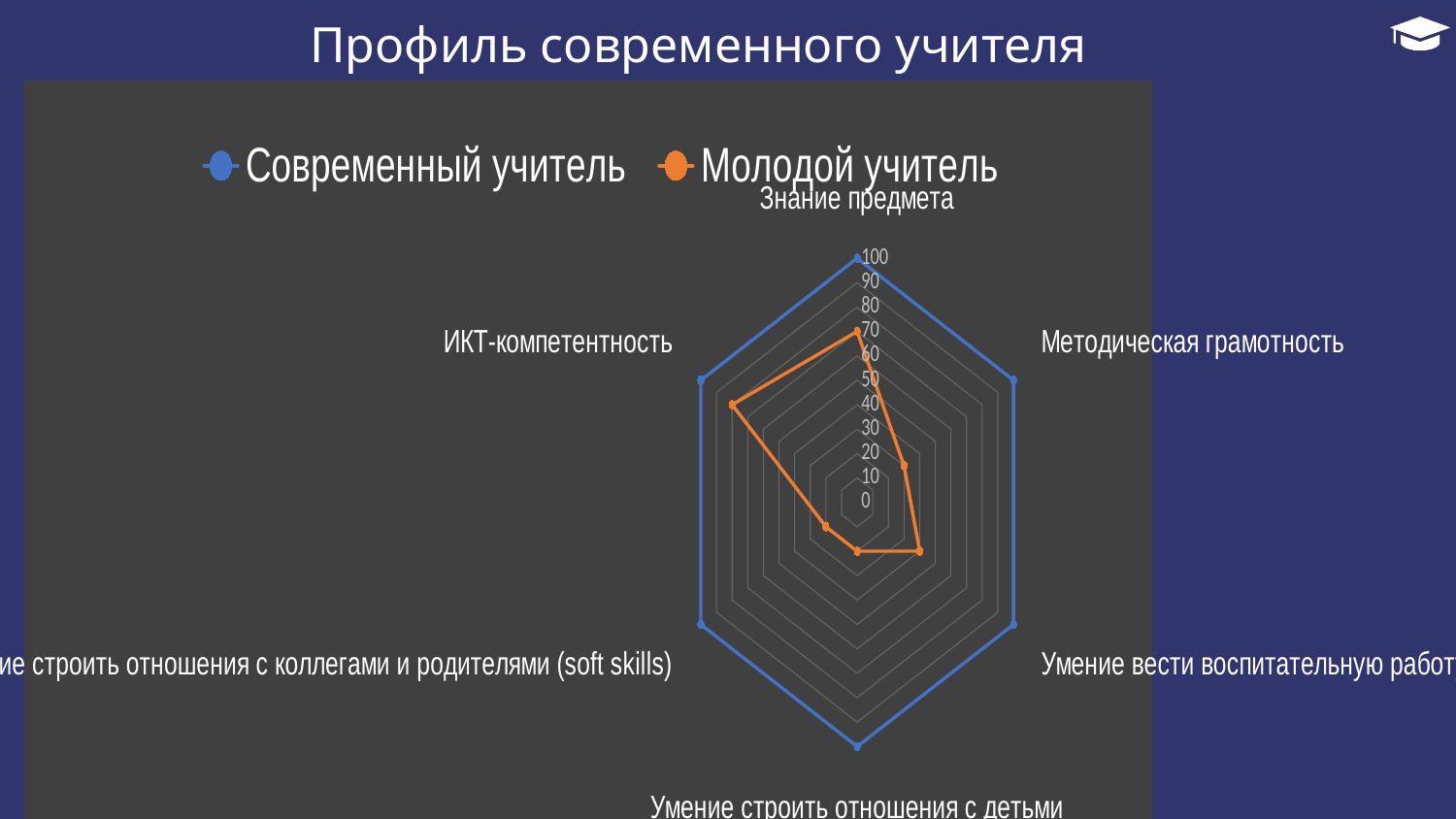
For the Молодой учитель series, which is larger: ИКТ-компетентность or Методическая грамотность? ИКТ-компетентность Is the value for Молодой учитель on Умение строить отношения с детьми greater or less than 50? less What kind of chart is shown on the slide? Radar chart Is the value for Молодой учитель on Методическая грамотность greater or less than 50? less On Знание предмета, which series has the larger value: Современный учитель or Молодой учитель? Современный учитель What is the value for Молодой учитель on Знание предмета? 70 For the Молодой учитель series, which category has the highest value? ИКТ-компетентность What is the value for Современный учитель on Знание предмета? 100 How many categories (axes) does the radar chart have? 6 Which colour represents the Молодой учитель series? Orange How many series does the legend list? 2